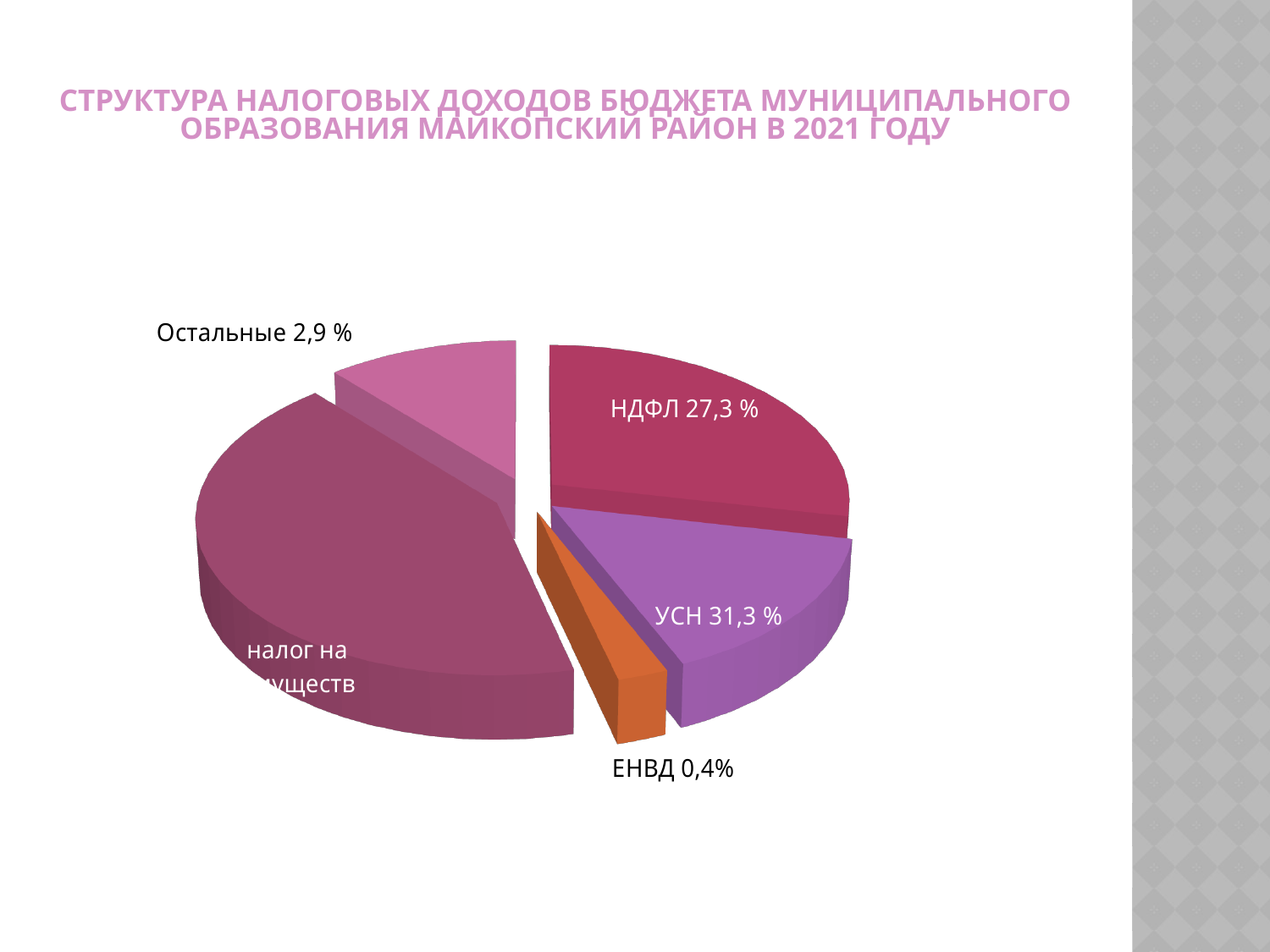
What is the value shown for Остальные? 2,9 % Which is larger, НДФЛ or УСН? УСН What is the value shown for ЕНВД? 0,4% How many slices does the pie chart have? 5 Which is larger, Остальные or ЕНВД? Остальные Which slice of the pie is the smallest? ЕНВД Which year does the chart title refer to? 2021 What is the value shown for УСН? 31,3 % What is the difference between the НДФЛ share and the Остальные share? 24,4 % What kind of chart is shown on the slide? pie chart What share of tax revenues does НДФЛ account for? 27,3 % By how many percentage points does УСН exceed НДФЛ? 4,0 %